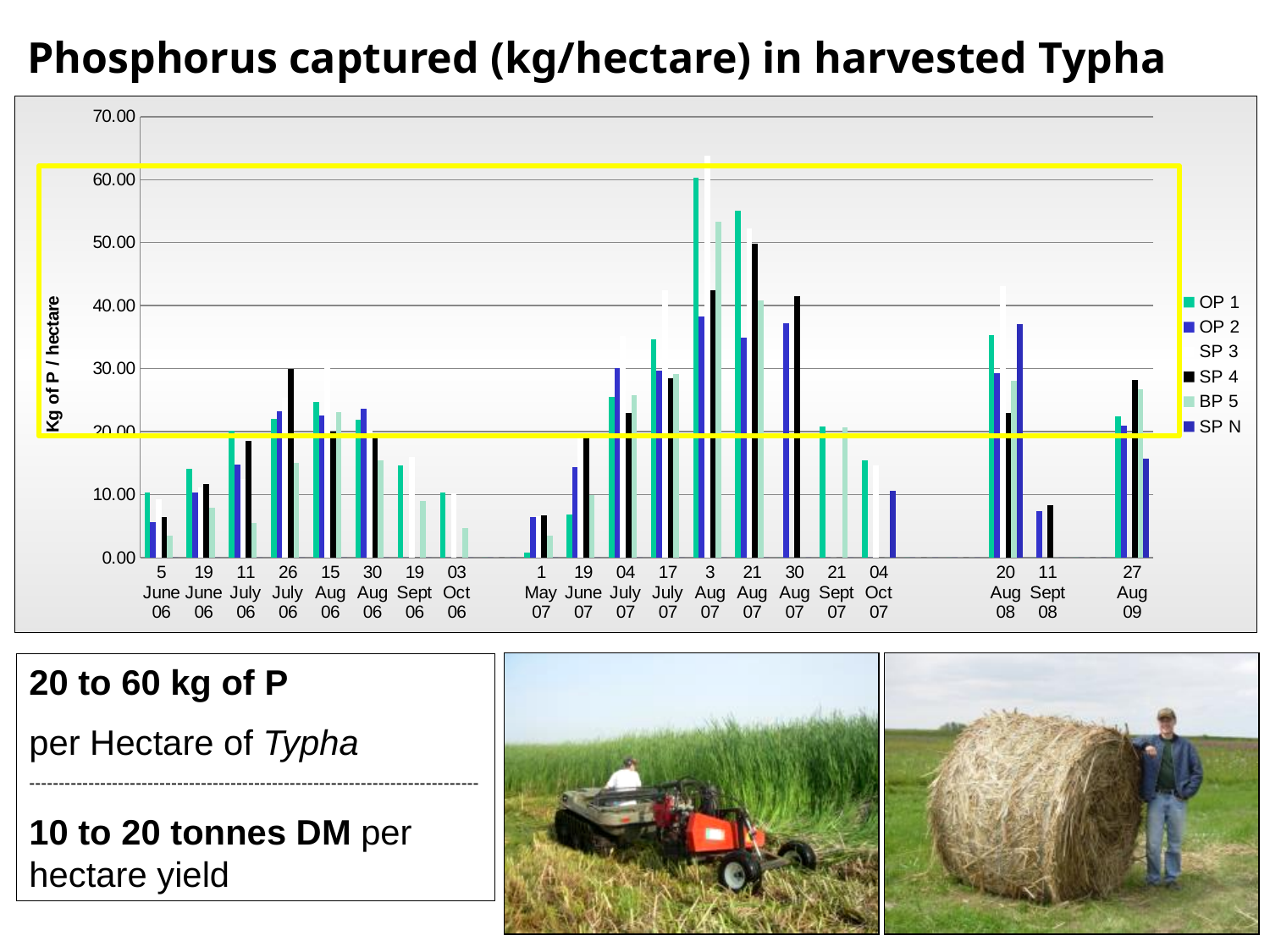
What is the label on the vertical axis of the chart? Kg of P / hectare On which harvest date does OP 1 reach its highest value? 3 Aug 07 What kind of chart is shown on the slide? bar chart How many series does the legend list? 6 Is the value for SP 4 on 21 Aug 07 greater or less than 40? greater Is the value for OP 1 on 04 Oct 07 greater or less than 20? less What is the highest value shown on the vertical axis? 70.00 Is the value for OP 1 on 3 Aug 07 greater or less than 50? greater Which is larger for SP 4: the value on 26 July 06 or the value on 11 July 06? 26 July 06